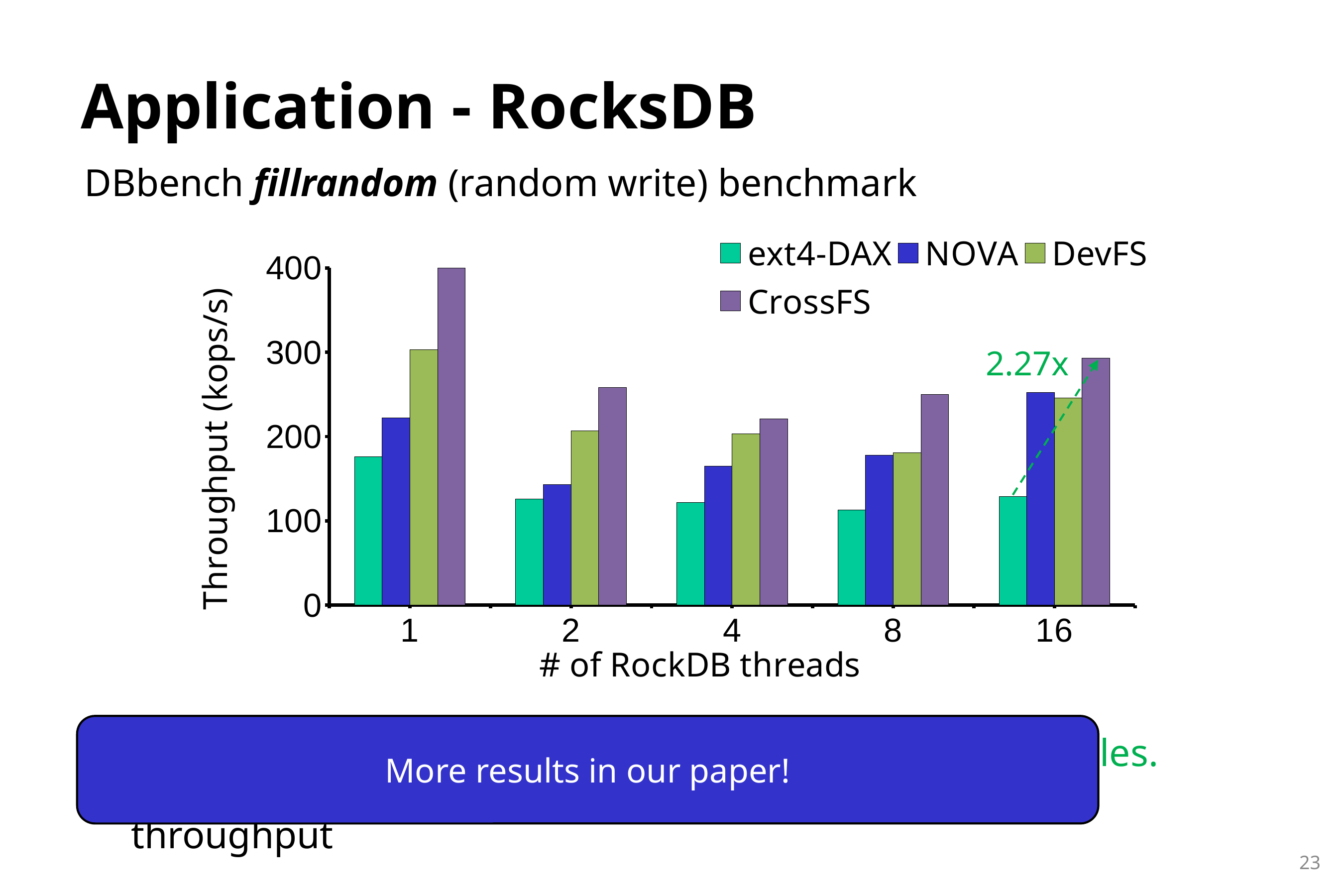
At which number of RockDB threads does CrossFS reach its highest throughput? 1 Is the CrossFS throughput at 1 thread greater or less than 300 kops/s? greater How many series does the legend list? 4 Does the CrossFS throughput rise or fall from 1 thread to 4 threads? fall At 4 RockDB threads, which has higher throughput, ext4-DAX or CrossFS? CrossFS Which file system has the highest throughput at 1 RockDB thread? CrossFS At 2 RockDB threads, which has higher throughput, NOVA or DevFS? DevFS Which file system has the lowest throughput at 16 RockDB threads? ext4-DAX Is the ext4-DAX throughput at 8 threads greater or less than 200 kops/s? less How many thread counts are shown along the x axis? 5 What speedup is annotated above the 16-thread group? 2.27x What kind of chart is shown on the slide? bar chart